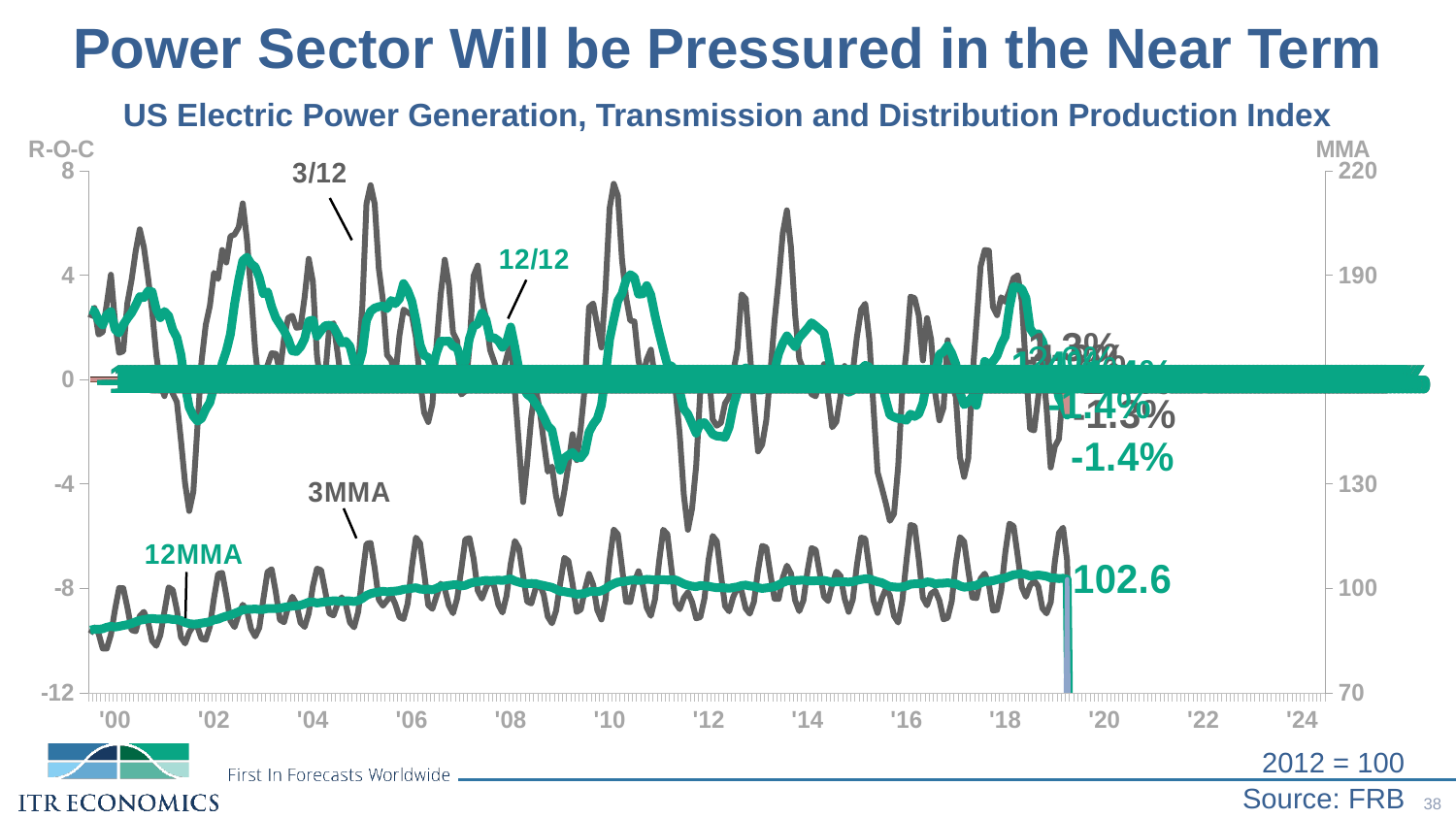
What is the latest labeled value of the 12/12 series? -1.4% Is the 12MMA value higher at '18 or at '00? '18 What is the highest tick value on the left (R-O-C) axis? 8 Does the 12MMA series generally rise or fall from '00 to '18? rise What base year is the index set to 100? 2012 What is the source of the data shown on the chart? FRB What is the title of the chart? US Electric Power Generation, Transmission and Distribution Production Index How many series are labeled on the chart? 4 What is the lowest tick value on the right (MMA) axis? 70 What is the latest labeled value of the 12MMA series? 102.6 Is the 12MMA value at the start of the chart ('00) greater or less than 100 on the MMA axis? less What kind of chart is shown on the slide? line chart